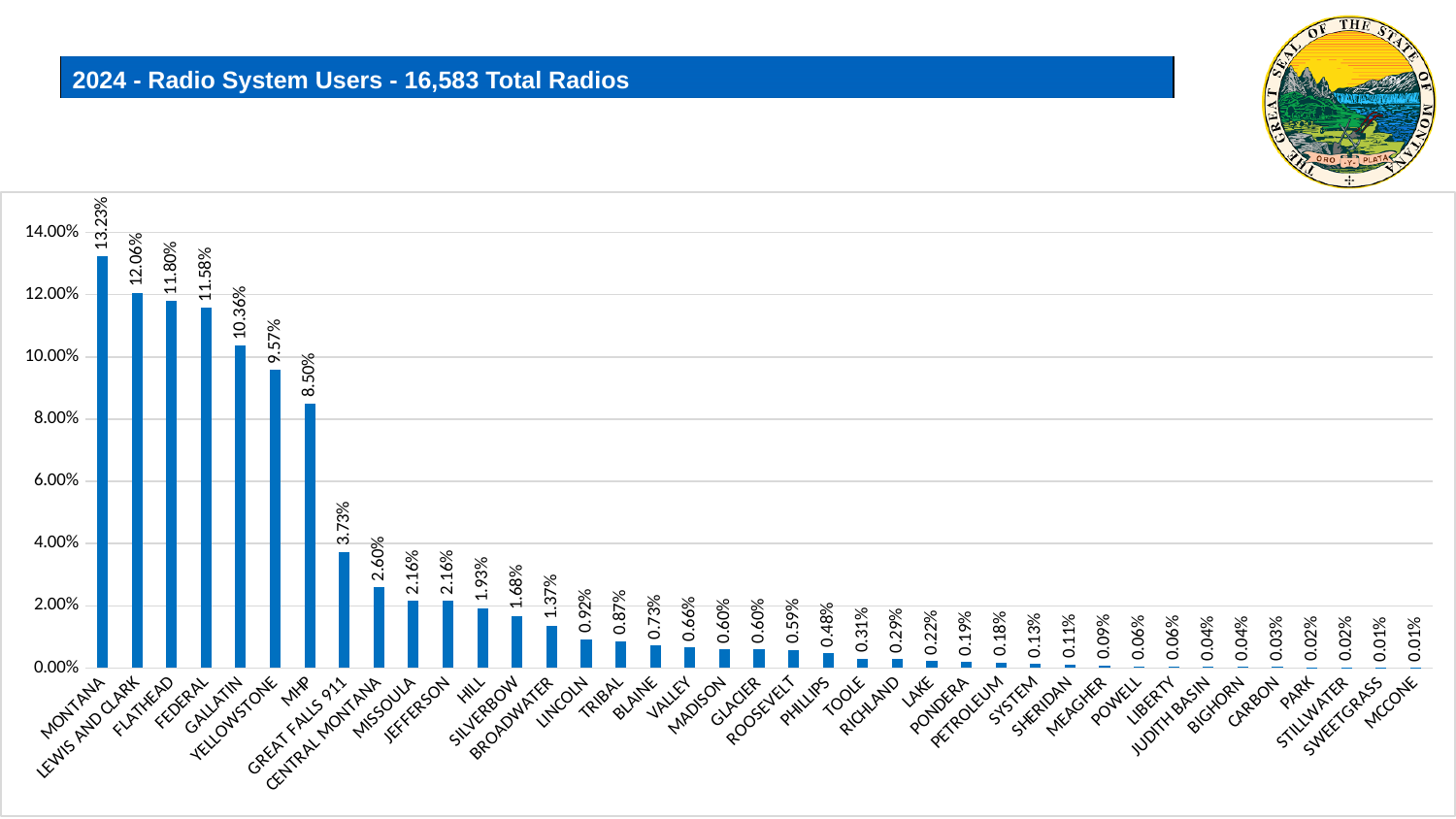
Which category has the highest percentage of radio system users? MONTANA Which has a larger value, FEDERAL or MHP? FEDERAL What is the difference between the values for GALLATIN and YELLOWSTONE? 0.79% How many categories are shown on the x axis of the chart? 39 What is the value shown for SILVERBOW? 1.68% What is the value shown for GREAT FALLS 911? 3.73% What percentage of radio system users does MONTANA account for? 13.23% What is the difference between the values for MONTANA and LEWIS AND CLARK? 1.17% Do the values rise or fall moving from left to right along the x axis? Fall Is the value for YELLOWSTONE greater or less than 10.00%? less What is the value shown for GALLATIN? 10.36% What kind of chart is shown on the slide? Bar chart